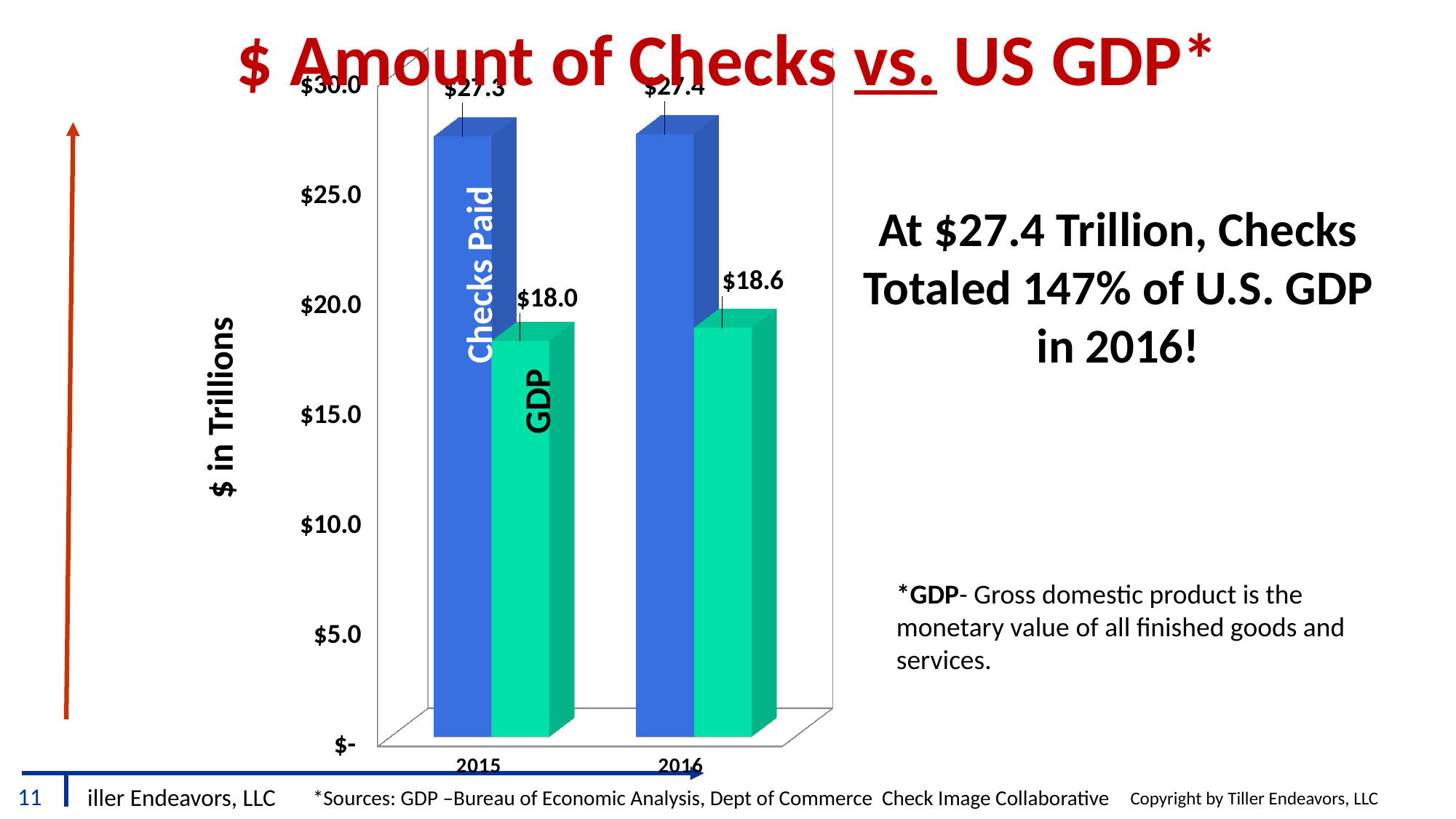
What is the value of GDP for 2015? $18.0 What is the difference between Checks Paid and GDP in 2015? $9.3 What is the value of Checks Paid for 2016? $27.4 Which series has the higher value in 2016, Checks Paid or GDP? Checks Paid How many years are shown on the x axis? 2 What is the value of GDP for 2016? $18.6 What type of chart is shown on the slide? Bar chart What is the label on the vertical axis of the chart? $ in Trillions What is the difference between Checks Paid and GDP in 2016? $8.8 How many data series are plotted in the chart? 2 What is the value of Checks Paid for 2015? $27.3 Does GDP rise or fall from 2015 to 2016? Rise